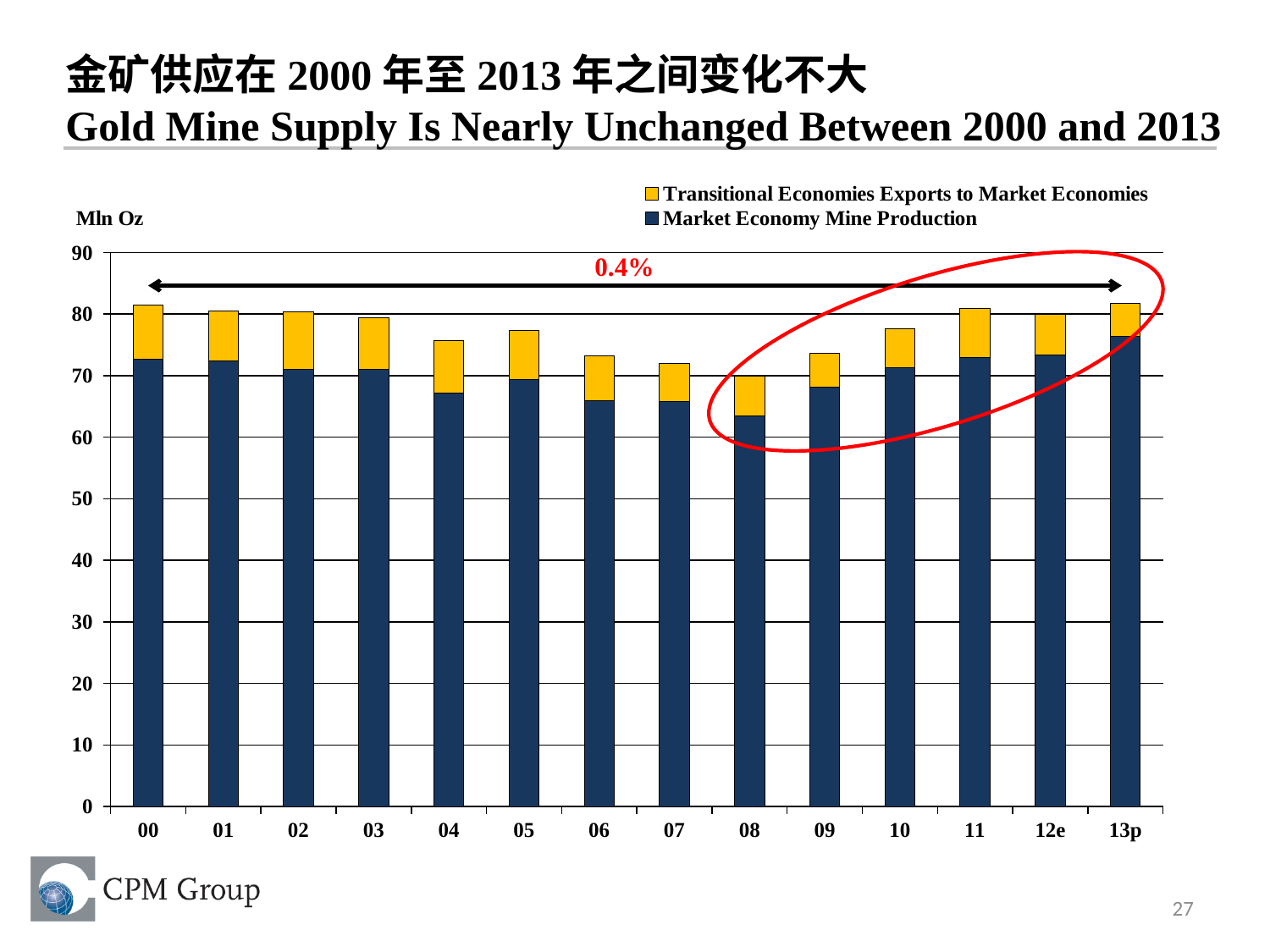
Which year has the highest Market Economy Mine Production? 13p Is the Market Economy Mine Production for 00 greater or less than 70? greater Which year has the lowest Market Economy Mine Production? 08 Which year has the larger total bar, 06 or 10? 10 Is the total bar for 08 greater or less than 80? less Do the total bars rise or fall from 00 to 08? fall How many years (categories) are shown along the x axis? 14 Which year has the lowest total gold mine supply? 08 How many series does the legend list? 2 What unit is shown on the y axis of the chart? Mln Oz What kind of chart is shown on the slide? bar chart Is the total bar for 04 greater or less than 80? less